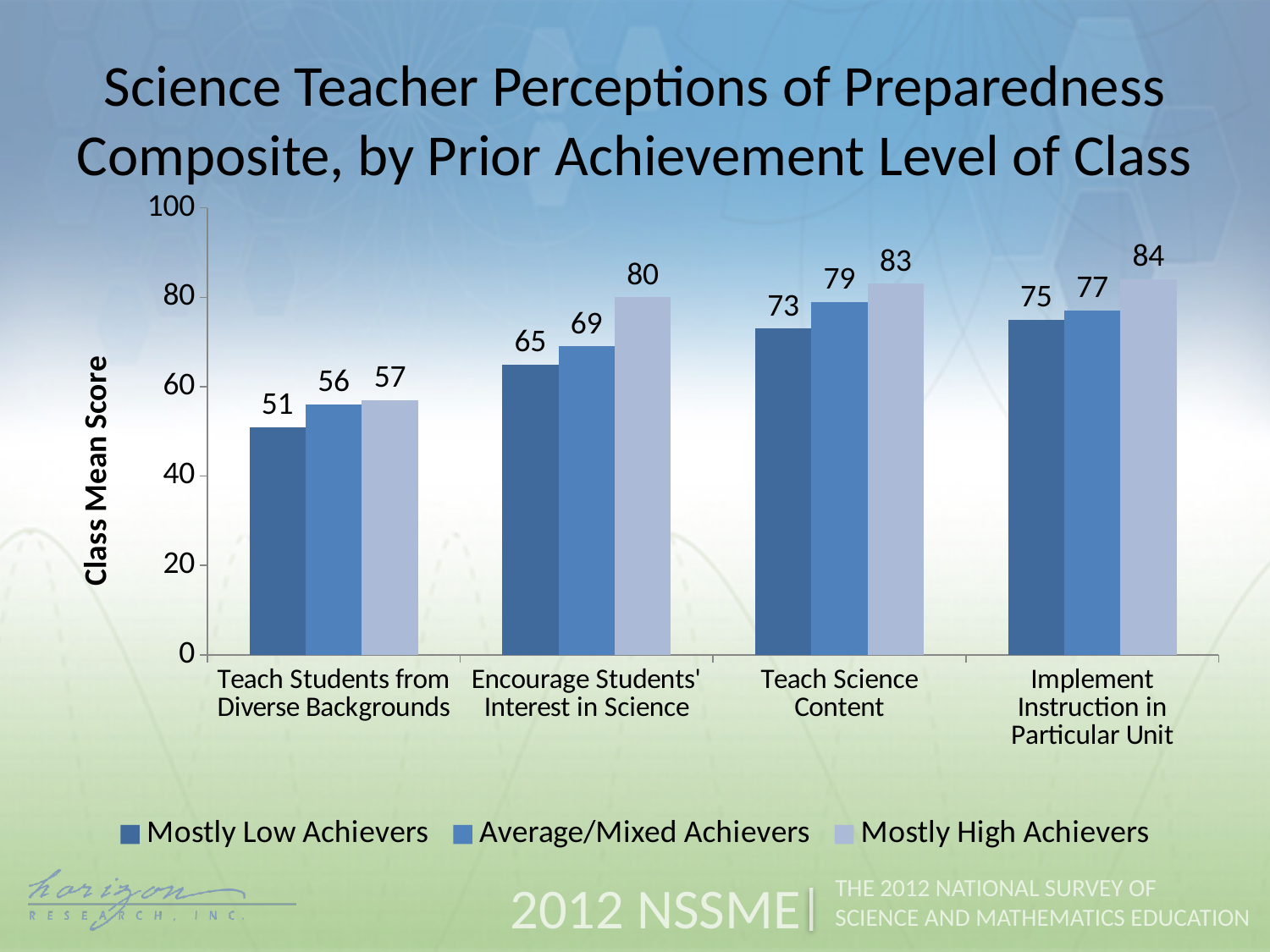
What is the difference between the Mostly High Achievers and Mostly Low Achievers scores for Encourage Students' Interest in Science? 15 What is the class mean score for Average/Mixed Achievers on Teach Science Content? 79 What is the class mean score for Mostly High Achievers on Encourage Students' Interest in Science? 80 What is the label of the y axis? Class Mean Score How many series does the legend list? 3 How many categories are shown on the x axis? 4 Which is larger: the Mostly Low Achievers score for Teach Science Content or the Mostly Low Achievers score for Implement Instruction in Particular Unit? Implement Instruction in Particular Unit Is the Average/Mixed Achievers score for Teach Students from Diverse Backgrounds greater or less than 60? less Which category has the lowest class mean score for Mostly Low Achievers? Teach Students from Diverse Backgrounds What is the class mean score for Mostly Low Achievers on Teach Students from Diverse Backgrounds? 51 Which category has the highest class mean score for Mostly High Achievers? Implement Instruction in Particular Unit What kind of chart is shown on the slide? bar chart